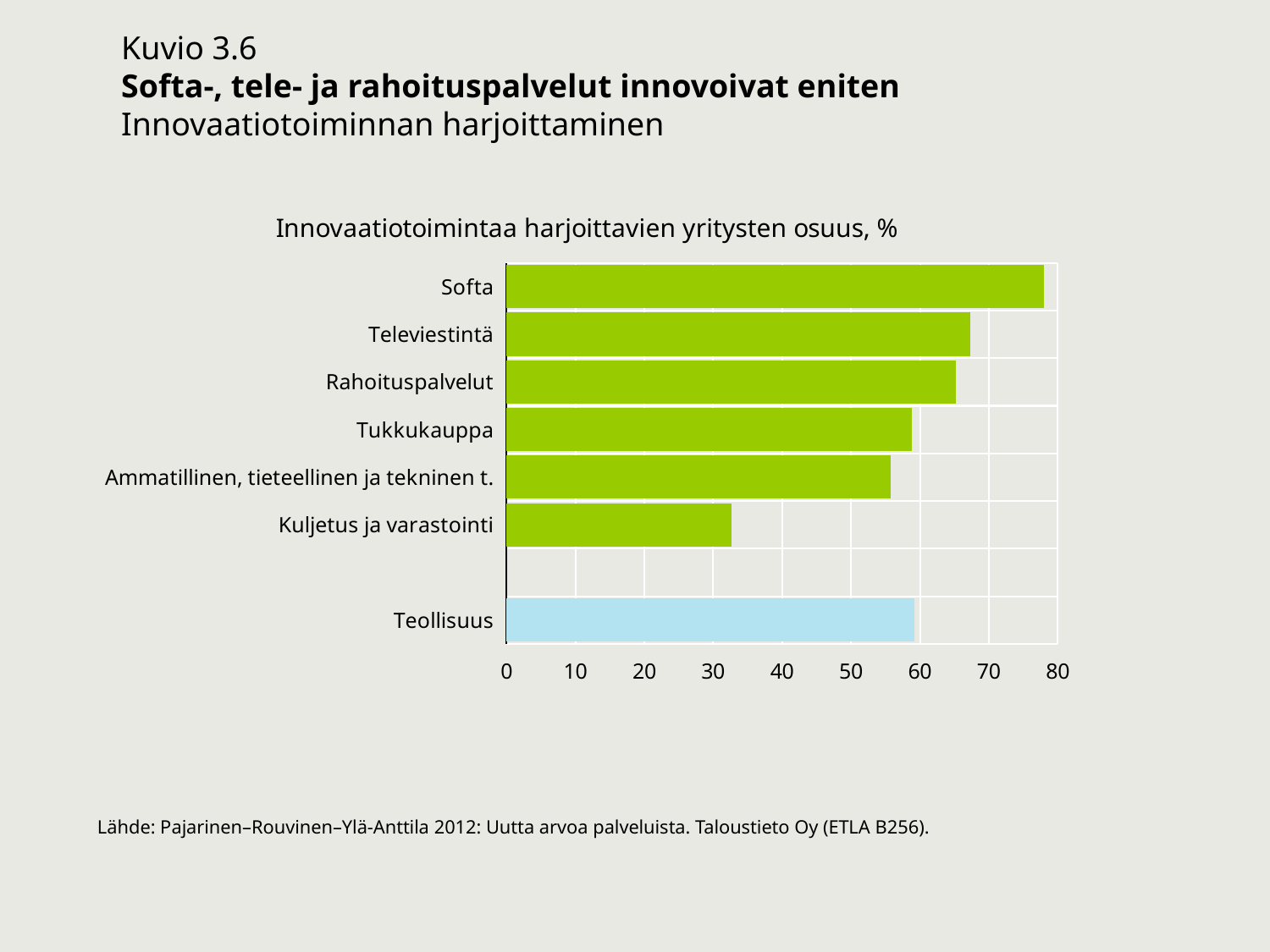
Which category has the lowest share of firms engaged in innovation activity? Kuljetus ja varastointi Is the value for Kuljetus ja varastointi greater or less than 40? less Which category's bar is shown in a different colour (light blue) from the others? Teollisuus What is the title of the chart? Innovaatiotoimintaa harjoittavien yritysten osuus, % Is the value for Ammatillinen, tieteellinen ja tekninen t. greater or less than 50? greater Which has a larger value, Softa or Televiestintä? Softa Which category has the highest share of firms engaged in innovation activity? Softa Is the value for Televiestintä greater or less than 60? greater Which has a larger value, Kuljetus ja varastointi or Teollisuus? Teollisuus How many categories (bars) are plotted in the chart? 7 What kind of chart is shown on the slide? bar chart